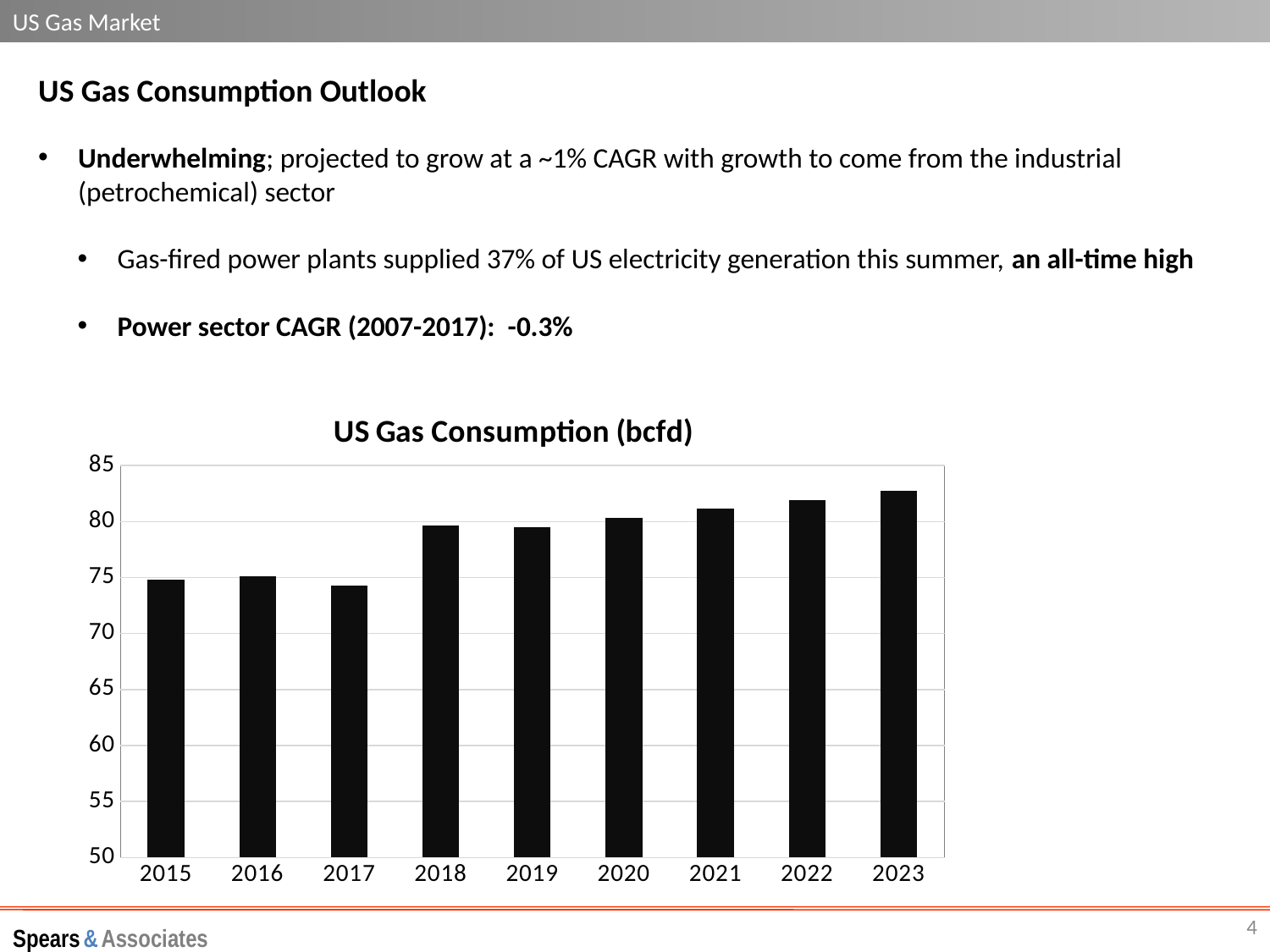
Is the value for 2023 greater or less than 85? less Which year has the larger value, 2017 or 2018? 2018 What is the title of the chart? US Gas Consumption (bcfd) Is the value for 2019 greater or less than 80? less Is the value for 2021 greater or less than 80? greater Which year has the highest US gas consumption in the chart? 2023 What colour are the bars in the chart? Black How many years are shown on the x axis of the chart? 9 What type of chart is shown on the slide? Bar chart Which year has the larger value, 2015 or 2023? 2023 Do the values generally rise or fall from 2015 to 2023? Rise